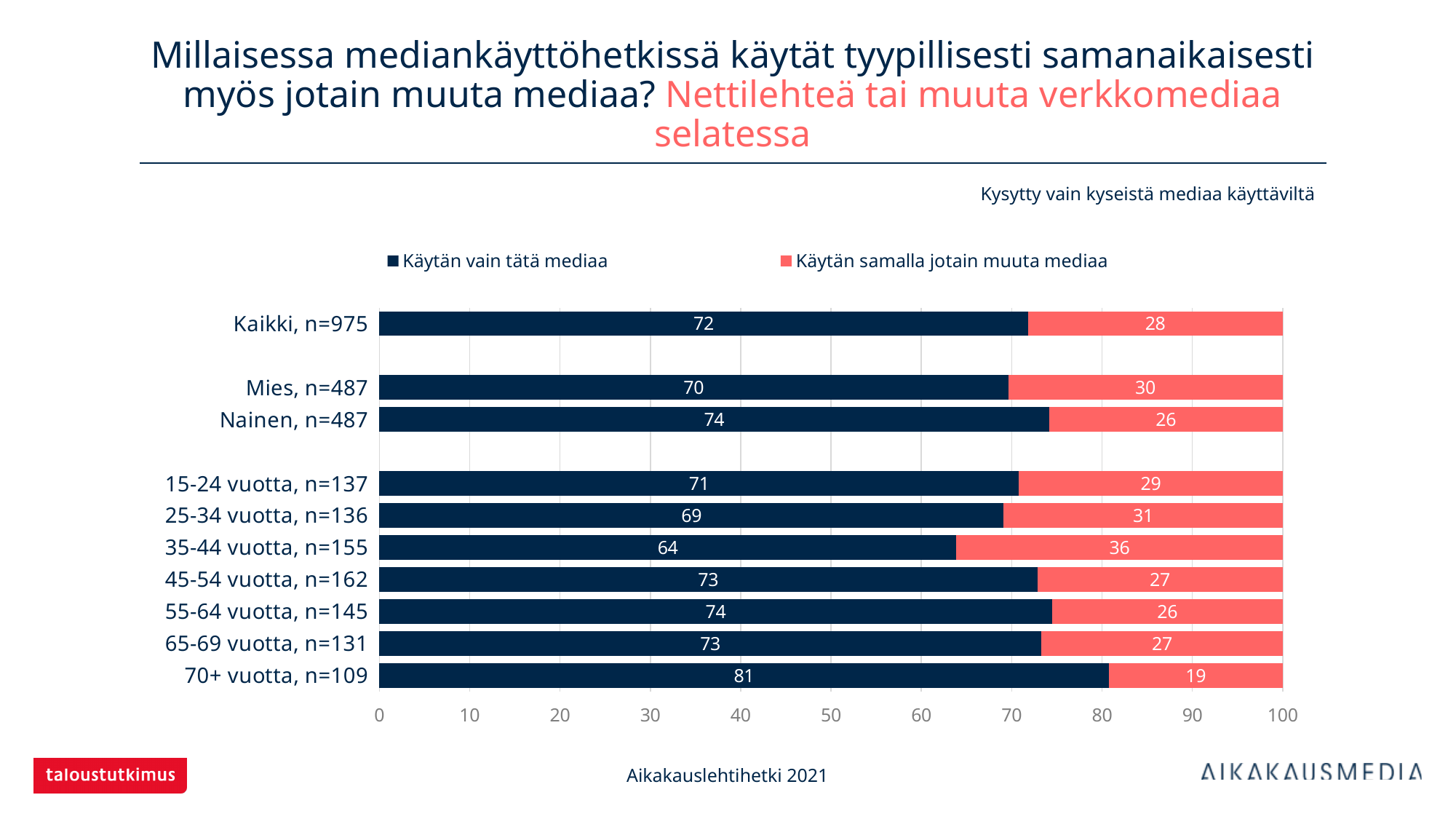
What is the total of the stacked bar for "55-64 vuotta, n=145"? 100 What is the difference between the "Käytän vain tätä mediaa" values for "Mies, n=487" and "Nainen, n=487"? 4 What kind of chart is shown on the slide? Stacked bar chart What is the value of "Käytän vain tätä mediaa" for "Kaikki, n=975"? 72 Which category has the lowest value for "Käytän samalla jotain muuta mediaa"? 70+ vuotta, n=109 What colour is the "Käytän samalla jotain muuta mediaa" series? Red (coral) Which category has the highest value for "Käytän vain tätä mediaa"? 70+ vuotta, n=109 What is the value of "Käytän samalla jotain muuta mediaa" for "35-44 vuotta, n=155"? 36 How many series does the legend list? 2 How many categories are shown on the chart? 10 What is the value of "Käytän vain tätä mediaa" for "70+ vuotta, n=109"? 81 Which is larger: the "Käytän samalla jotain muuta mediaa" value for "25-34 vuotta, n=136" or for "45-54 vuotta, n=162"? 25-34 vuotta, n=136